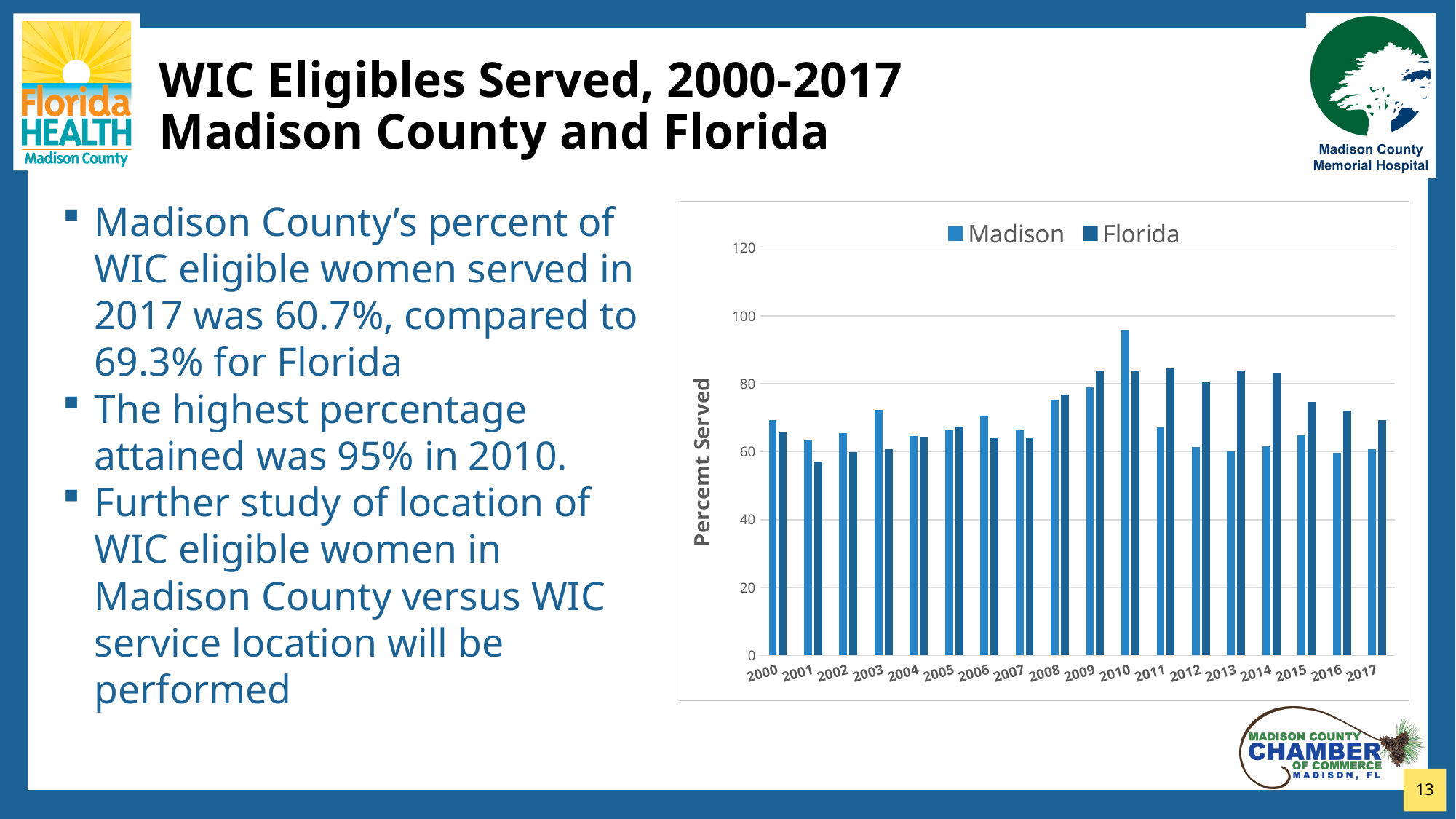
In 2013, which is larger, the Madison bar or the Florida bar? Florida Is the Florida value for 2011 greater or less than 80? greater How many years are shown on the x axis of the chart? 18 In 2003, which is larger, the Madison bar or the Florida bar? Madison What was Florida's percent of WIC eligible women served in 2017? 69.3% How many series does the chart legend list? 2 What kind of chart is shown on the slide? bar chart In which year is the Madison bar highest? 2010 What are the two entries in the chart legend? Madison and Florida Is the Florida value for 2001 greater or less than 60? less Is the Madison value for 2010 greater or less than 80? greater What was Madison County's percent of WIC eligible women served in 2017? 60.7%